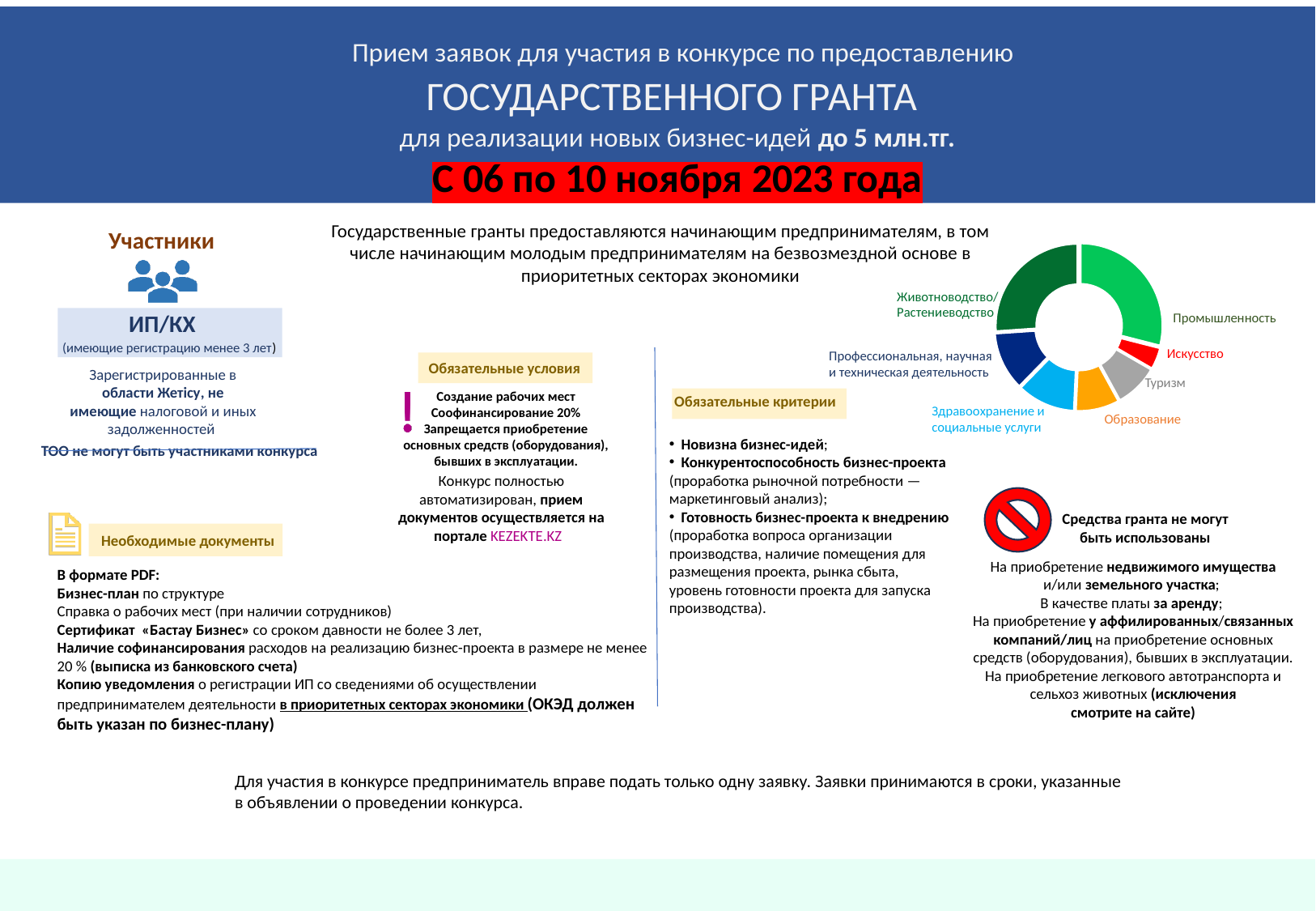
What kind of chart is shown on the right side of the slide? Pie (donut) chart What colour is the Искусство slice in the donut chart? Red In the donut chart, which slice is larger: Животноводство/Растениеводство or Туризм? Животноводство/Растениеводство How many sectors are shown in the donut chart on the right side of the slide? 7 In the donut chart, which slice is larger: Промышленность or Искусство? Промышленность In the donut chart, which slice is larger: Промышленность or Образование? Промышленность In the donut chart, which sector has the smallest slice? Искусство What colour is the Образование slice in the donut chart? Orange